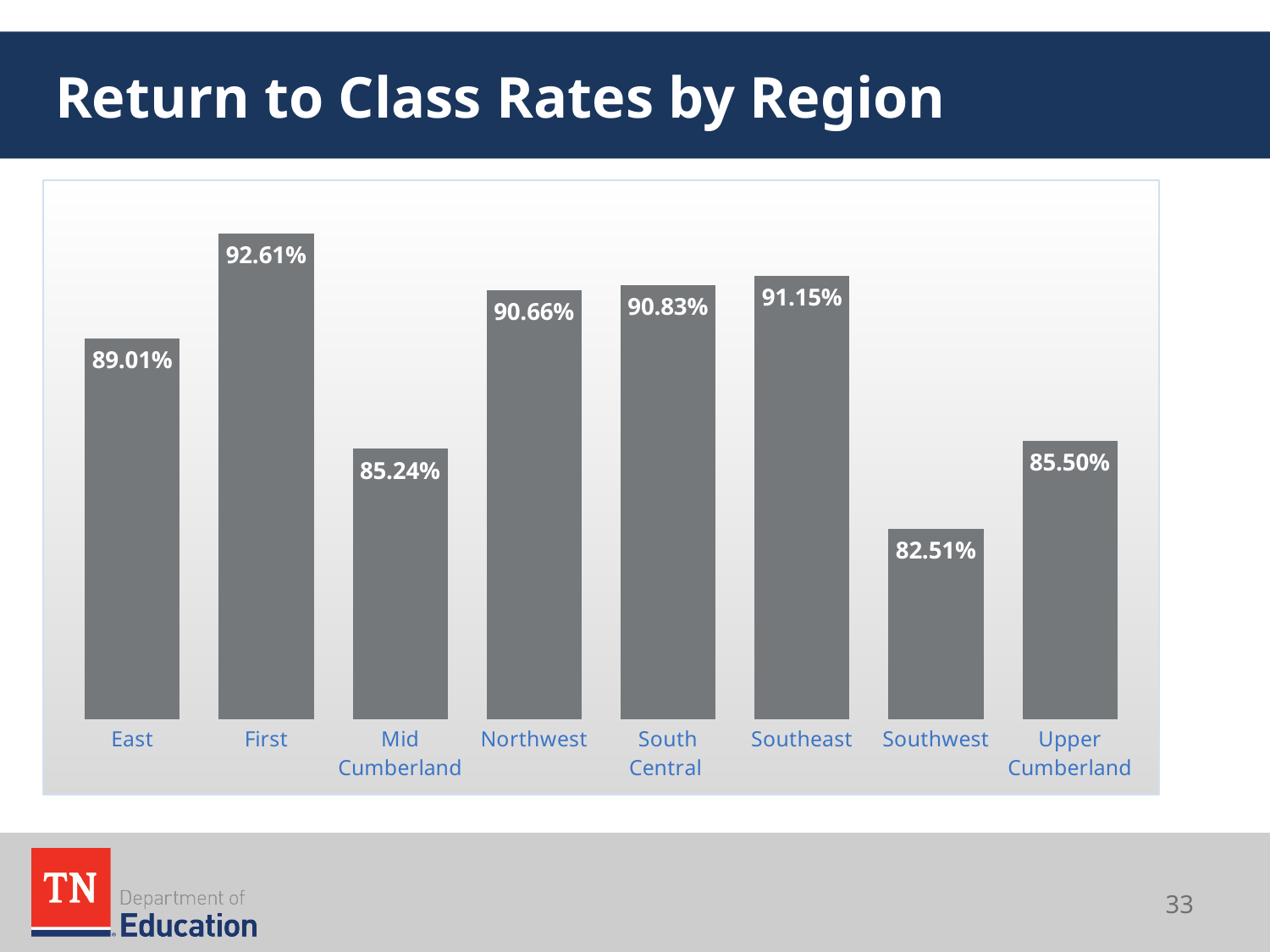
Which region has a higher return to class rate, East or South Central? South Central What is the title of the slide? Return to Class Rates by Region What is the difference between the return to class rates of First and Southwest? 10.10% How many regions are shown in the chart? 8 What is the return to class rate for the East region? 89.01% Which region has a higher return to class rate, Mid Cumberland or Upper Cumberland? Upper Cumberland What is the return to class rate for Upper Cumberland? 85.50% What type of chart is shown on the slide? Bar chart Which region has the highest return to class rate? First What is the return to class rate for Southwest? 82.51% Which region has the lowest return to class rate? Southwest What is the difference between the return to class rates of Southeast and Northwest? 0.49%